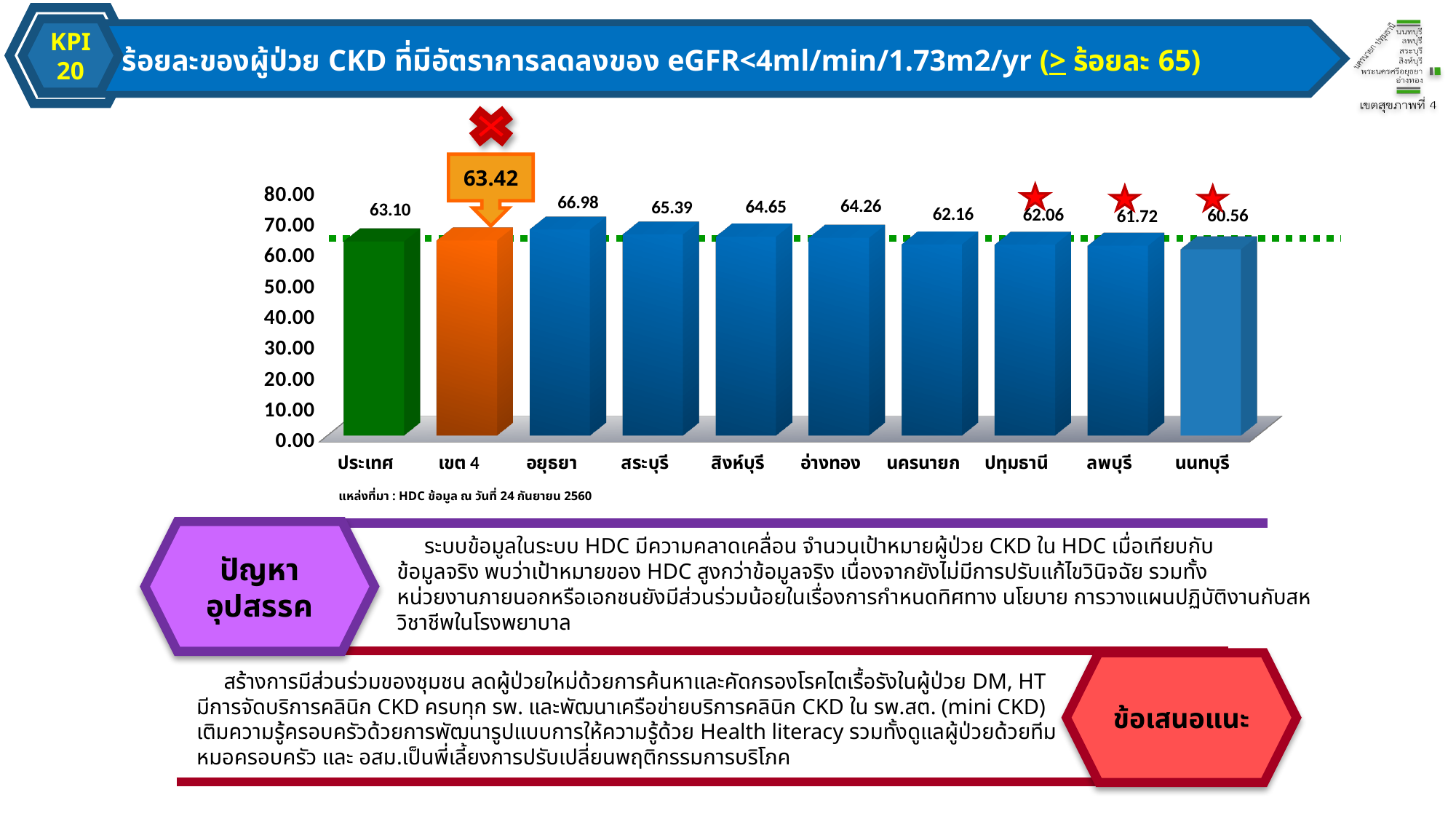
What is the value for ลพบุรี? 61.72 What is the value for เขต 4? 63.42 How many categories are shown on the x axis? 10 Which is larger, the value for สระบุรี or the value for อ่างทอง? สระบุรี What is the value for ประเทศ? 63.10 What kind of chart is shown on the slide? bar chart What is the difference between the values for อยุธยา and นนทบุรี? 6.42 What is the value for อยุธยา? 66.98 What is the difference between the values for เขต 4 and ประเทศ? 0.32 Which category has the lowest value? นนทบุรี Which category has the highest value? อยุธยา What is the value for นนทบุรี? 60.56